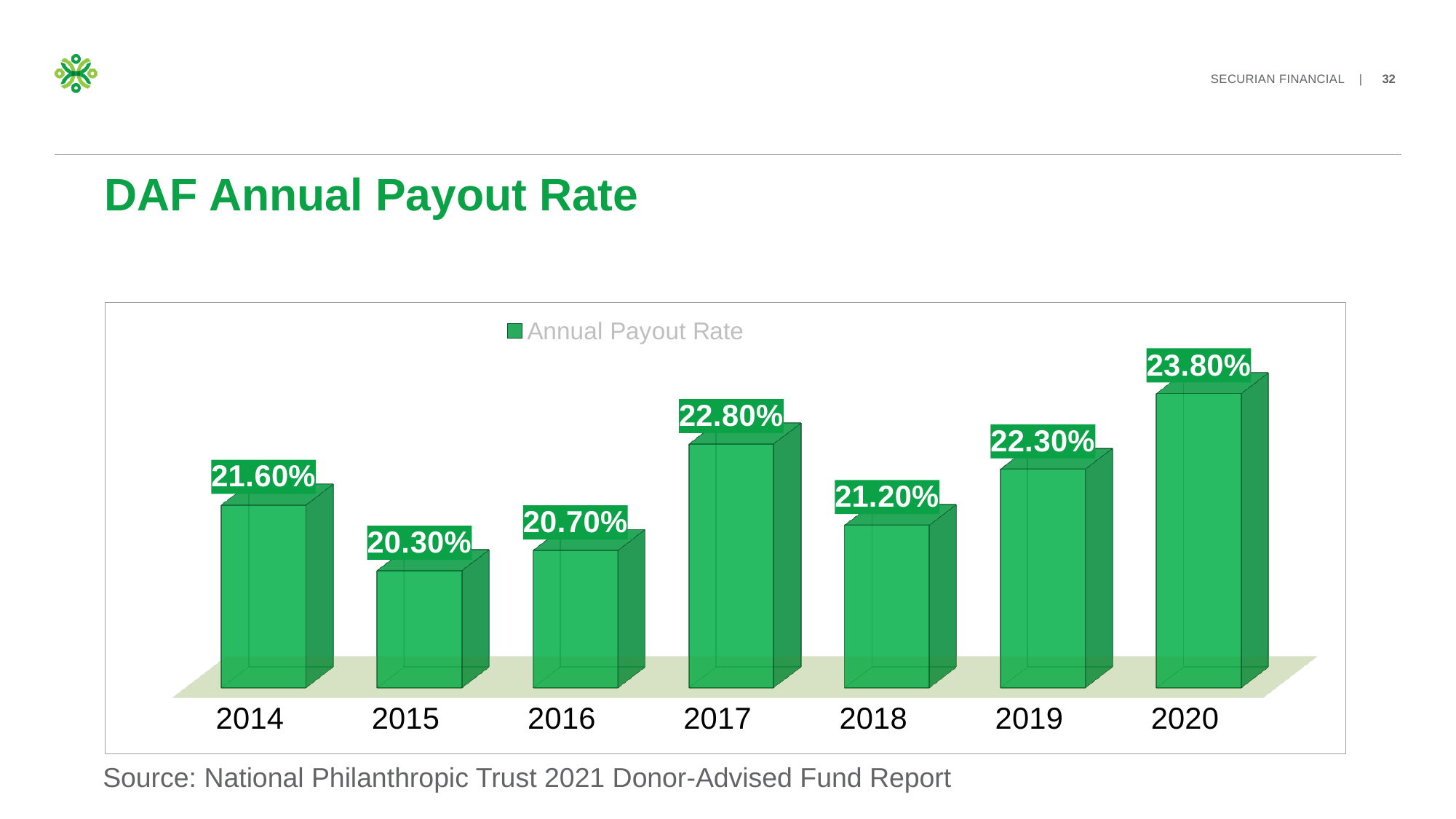
What is the difference between the Annual Payout Rate in 2017 and in 2018? 1.60% What is the difference between the Annual Payout Rate in 2020 and in 2015? 3.50% How many years are shown on the chart? 7 Which year has a higher Annual Payout Rate, 2016 or 2019? 2019 What is the Annual Payout Rate for 2020? 23.80% What is the title of the chart on the slide? DAF Annual Payout Rate What is the Annual Payout Rate for 2017? 22.80% What kind of chart is shown on the slide? Bar chart Which year has the lowest Annual Payout Rate? 2015 Which year has the highest Annual Payout Rate? 2020 What is the Annual Payout Rate for 2014? 21.60% How many series does the legend list? 1